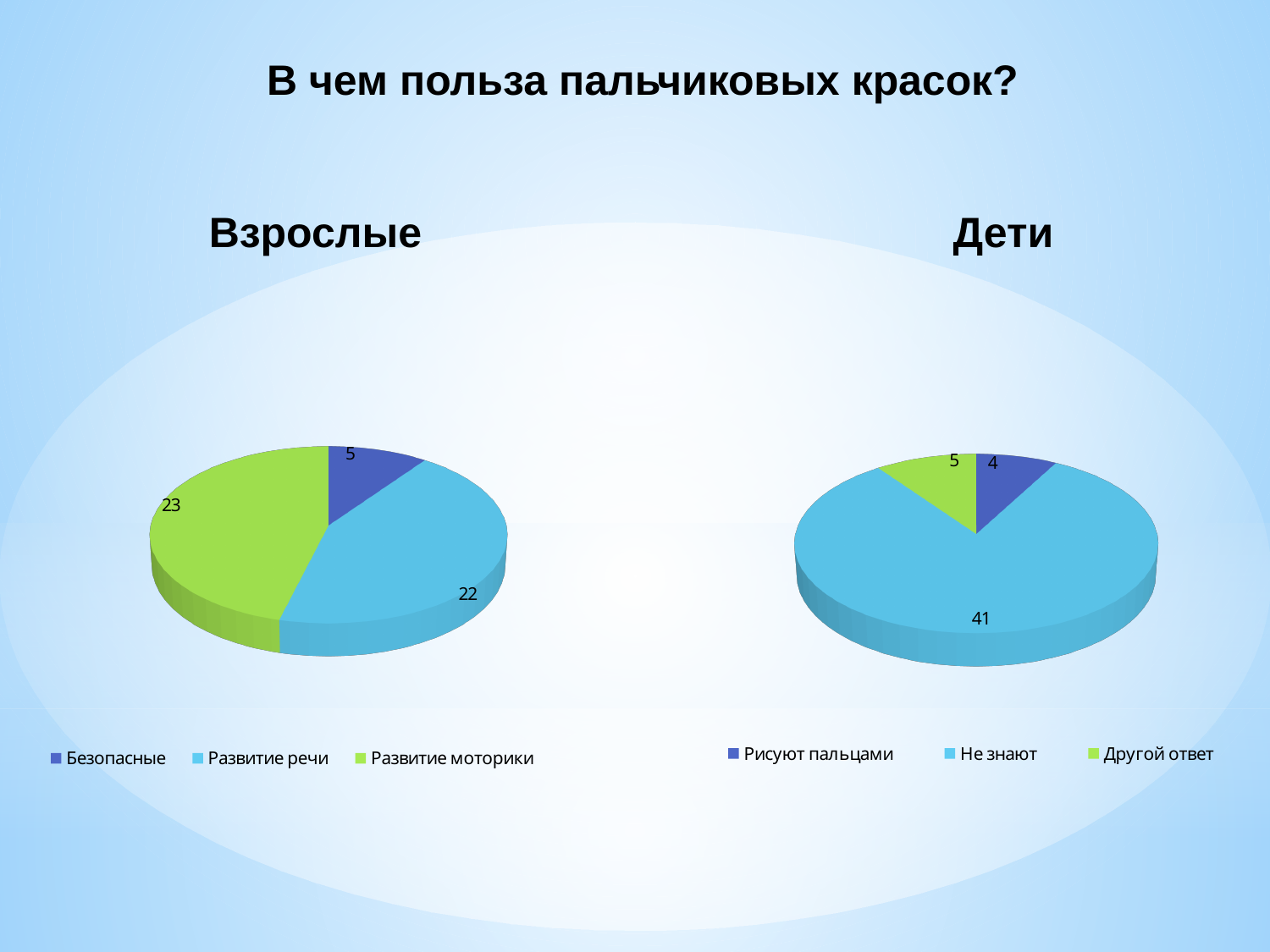
In the "Дети" chart, which category has the largest slice? Не знают In the "Взрослые" chart, which category has the smallest slice? Безопасные What type of chart is the "Дети" chart? Pie chart In the "Дети" chart, what is the value for "Рисуют пальцами"? 4 In the "Взрослые" chart, what is the value for "Безопасные"? 5 In the "Дети" chart, what is the value for "Не знают"? 41 In the "Взрослые" chart, what is the value for "Развитие речи"? 22 In the "Дети" chart, which is larger: "Другой ответ" or "Рисуют пальцами"? Другой ответ In the "Взрослые" chart, what is the difference between "Развитие моторики" and "Безопасные"? 18 In the "Дети" chart, what share of the total does "Не знают" represent? 82% In the "Дети" chart, which category has the smallest slice? Рисуют пальцами How many categories does the "Взрослые" chart show? 3